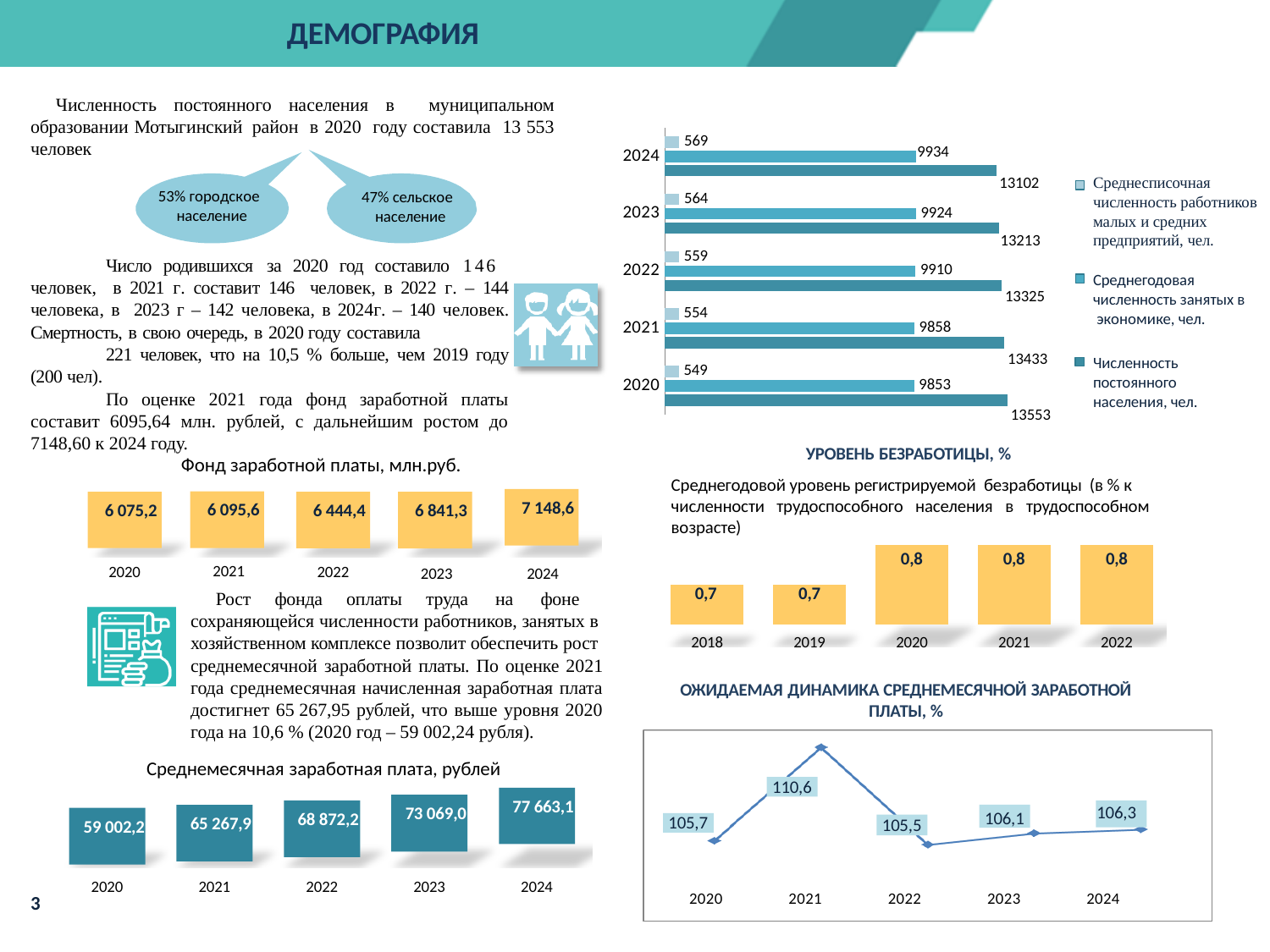
In the horizontal bar chart at the top right, what is the value for 'Численность постоянного населения, чел.' in 2020? 13553 In the horizontal bar chart at the top right, does the value for 'Численность постоянного населения, чел.' rise or fall from 2020 to 2024? fall In the chart 'Ожидаемая динамика среднемесячной заработной платы, %', which year has the highest value? 2021 In the chart 'Среднемесячная заработная плата, рублей', how many years are shown? 5 In the chart 'Фонд заработной платы, млн.руб.', which year has the highest value? 2024 In the chart 'Среднемесячная заработная плата, рублей', what is the value for 2023? 73 069,0 In the horizontal bar chart at the top right, what is the difference between 'Среднегодовая численность занятых в экономике, чел.' in 2024 and in 2020? 81 In the chart 'Фонд заработной платы, млн.руб.', what is the value for 2022? 6 444,4 In the horizontal bar chart at the top right, how many series does the legend list? 3 What kind of chart is 'Ожидаемая динамика среднемесячной заработной платы, %'? line chart In the horizontal bar chart at the top right, what is the value for 'Среднесписочная численность работников малых и средних предприятий, чел.' in 2024? 569 In the chart 'Уровень безработицы, %', what is the value for 2019? 0,7